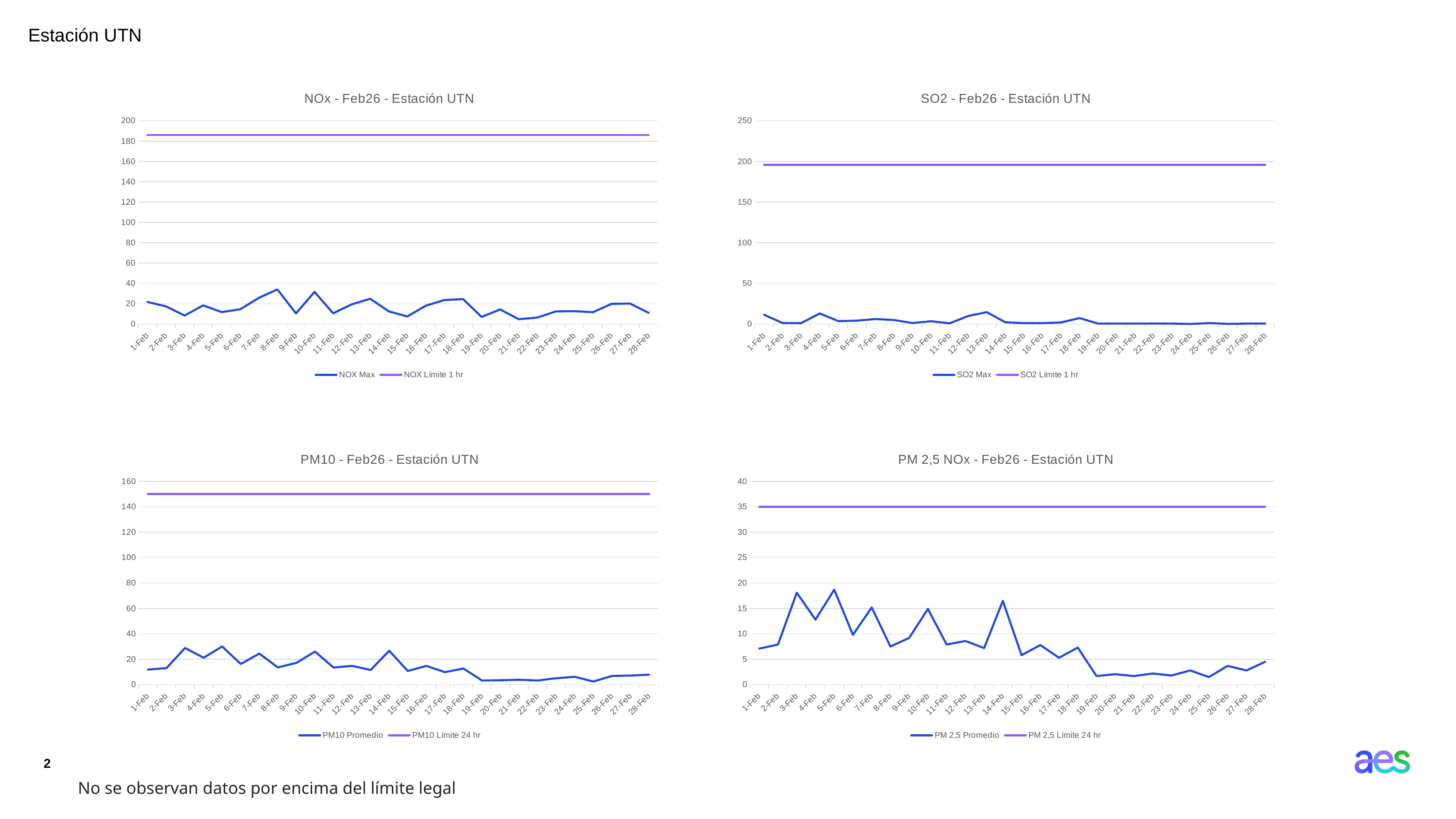
In the 'PM 2,5 NOx - Feb26 - Estación UTN' chart, is the PM 2,5 Promedio value on 19-Feb greater or less than 5? less How many series does the legend of the 'SO2 - Feb26 - Estación UTN' chart list? 2 In the 'NOx - Feb26 - Estación UTN' chart, is the NOX Límite 1 hr line greater or less than 180? greater In the 'PM 2,5 NOx - Feb26 - Estación UTN' chart, what is the value of the PM 2,5 Límite 24 hr line? 35 In the 'PM 2,5 NOx - Feb26 - Estación UTN' chart, which date has the larger PM 2,5 Promedio value, 3-Feb or 19-Feb? 3-Feb In the 'PM10 - Feb26 - Estación UTN' chart, is the PM10 Promedio value on 25-Feb greater or less than 20? less What kind of chart is the 'NOx - Feb26 - Estación UTN' chart? line chart What are the two legend entries of the 'PM10 - Feb26 - Estación UTN' chart? PM10 Promedio and PM10 Límite 24 hr In the 'PM 2,5 NOx - Feb26 - Estación UTN' chart, are the PM 2,5 Promedio values from 19-Feb onward generally higher or lower than those in the first half of the month? lower How many dates are plotted along the x axis of the 'PM10 - Feb26 - Estación UTN' chart? 28